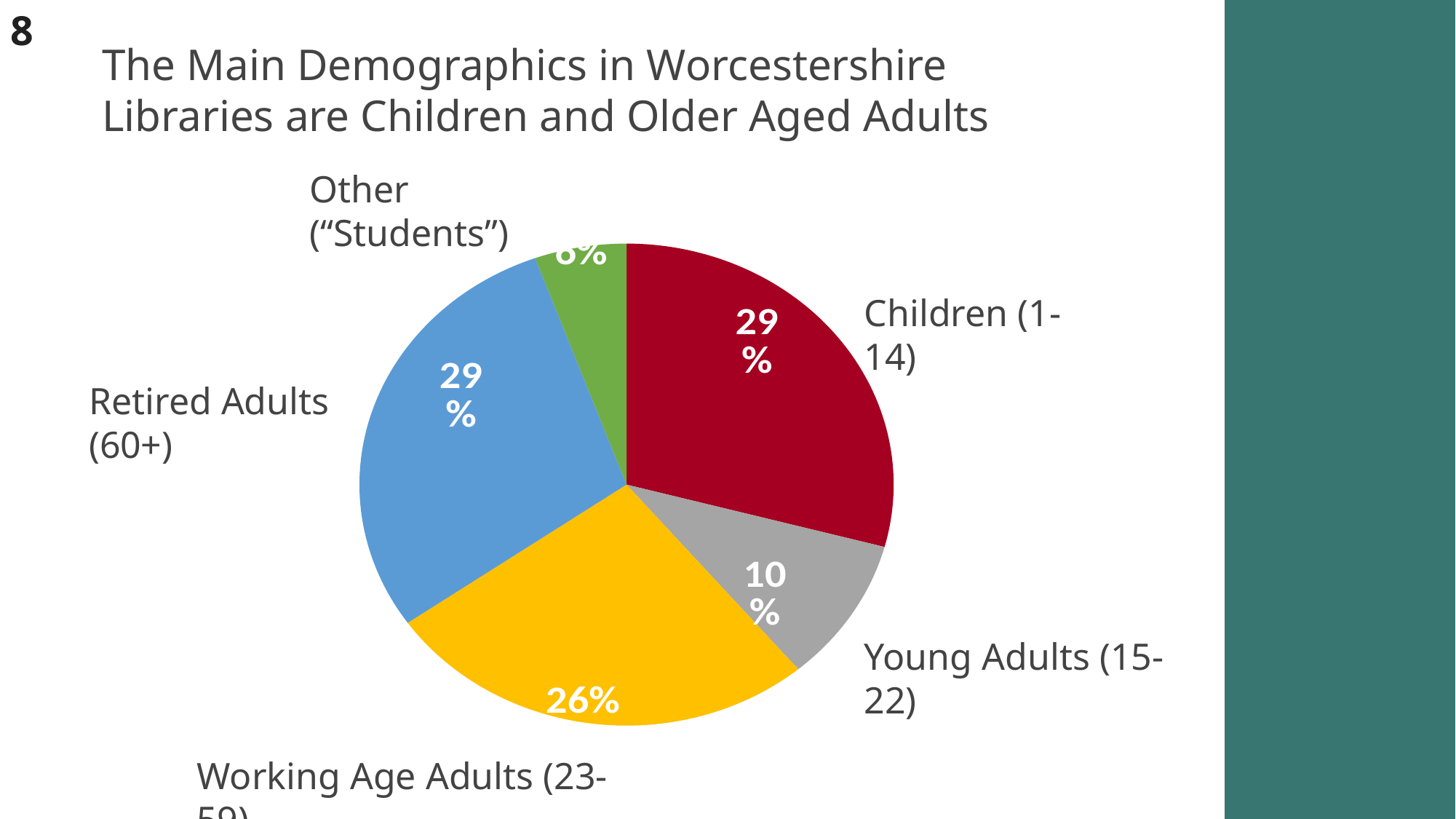
How many categories are shown in the pie chart? 5 What percentage of the pie is Children (1-14)? 29% What is the difference in percentage points between Children (1-14) and Young Adults (15-22)? 19 What is the difference in percentage points between Retired Adults (60+) and Working Age Adults (23-59)? 3 Which is larger: the slice for Working Age Adults (23-59) or the slice for Young Adults (15-22)? Working Age Adults (23-59) What percentage of the pie is Young Adults (15-22)? 10% What percentage of the pie is Working Age Adults (23-59)? 26% What percentage of the pie is Retired Adults (60+)? 29% Which category has the smallest slice of the pie? Other ("Students") What percentage of the pie is Other ("Students")? 6% What kind of chart is shown on the slide? Pie chart What is the title of the slide containing the pie chart? The Main Demographics in Worcestershire Libraries are Children and Older Aged Adults